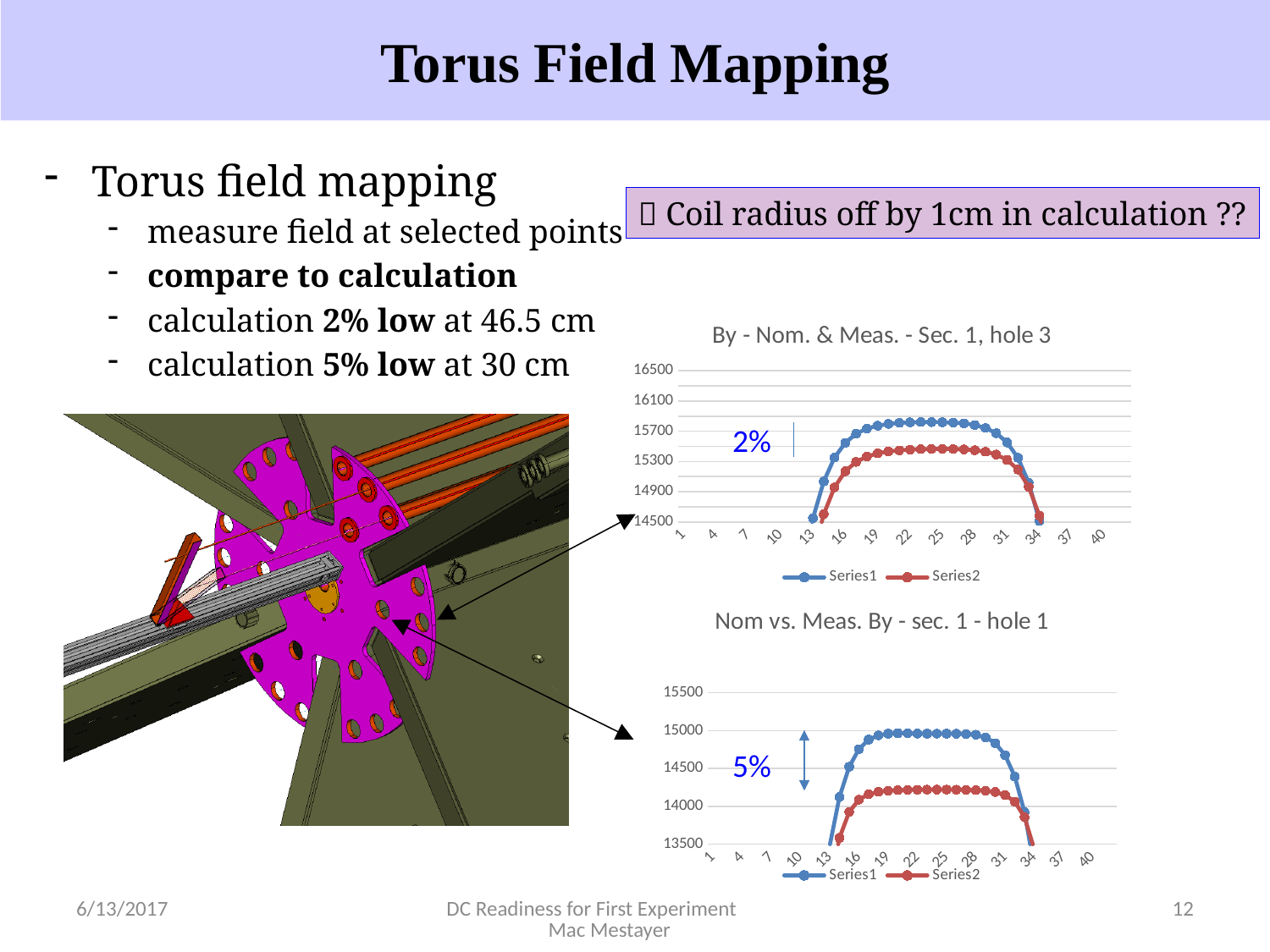
In the top chart 'By - Nom. & Meas. - Sec. 1, hole 3', which series has the higher values at its plateau, Series1 or Series2? Series1 What kind of chart is the top chart titled 'By - Nom. & Meas. - Sec. 1, hole 3'? line chart What is the title of the top chart on the slide? By - Nom. & Meas. - Sec. 1, hole 3 In the bottom chart 'Nom vs. Meas. By - sec. 1 - hole 1', is the plateau value of Series2 greater or less than 14000? greater In the top chart 'By - Nom. & Meas. - Sec. 1, hole 3', is the plateau value of Series2 greater or less than 15300? greater In the bottom chart 'Nom vs. Meas. By - sec. 1 - hole 1', which series is drawn in blue? Series1 In the bottom chart 'Nom vs. Meas. By - sec. 1 - hole 1', is the plateau value of Series2 greater or less than 14500? less In the top chart 'By - Nom. & Meas. - Sec. 1, hole 3', do the Series1 values rise or fall between x = 13 and x = 22? rise How many series does the legend of the bottom chart 'Nom vs. Meas. By - sec. 1 - hole 1' list? 2 In the bottom chart 'Nom vs. Meas. By - sec. 1 - hole 1', which series has the lower values at its plateau, Series1 or Series2? Series2